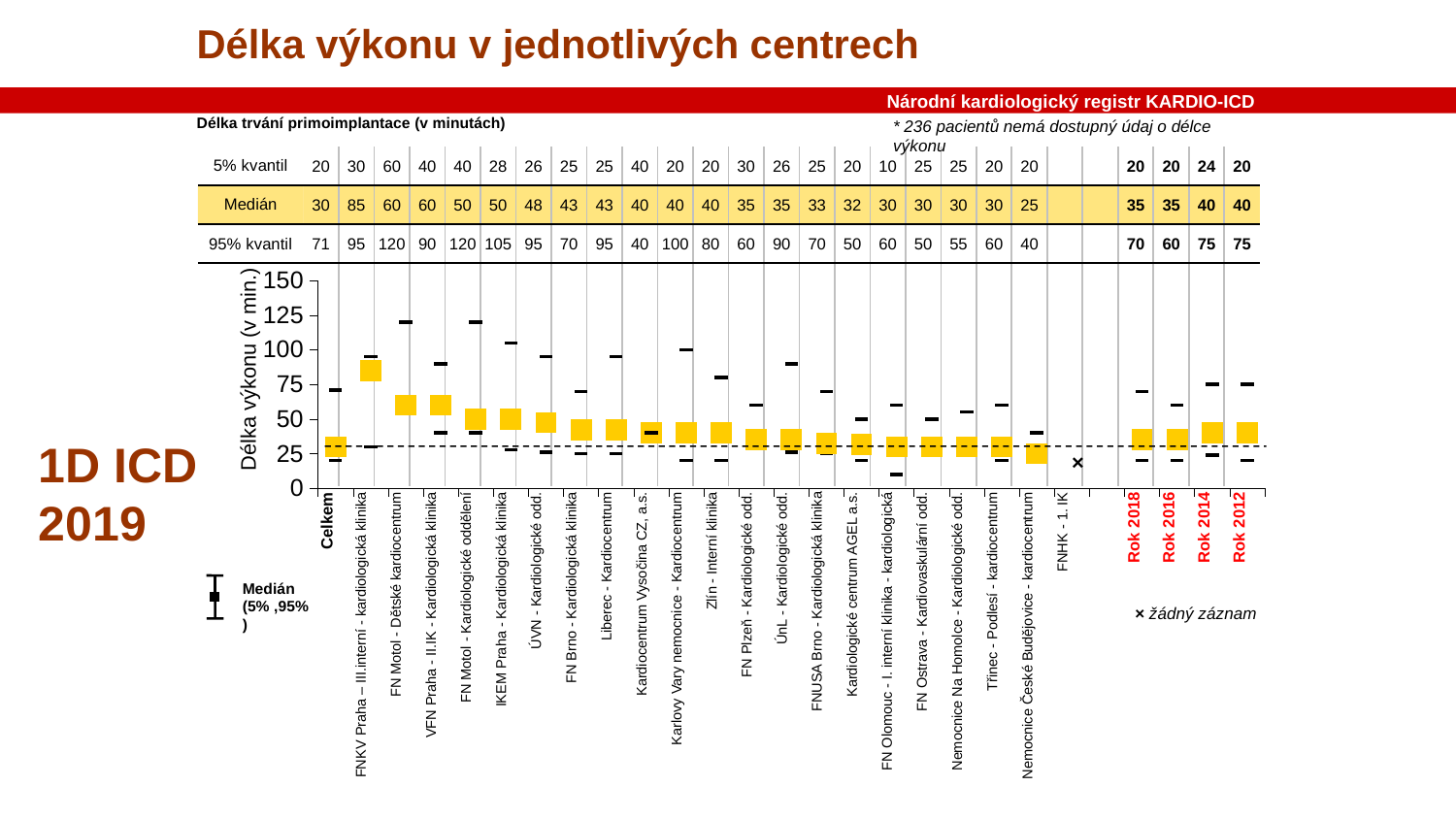
Which centre has the highest median procedure duration? FNKV Praha – III.interní - kardiologická klinika What is the 95% kvantil value for FN Motol - Dětské kardiocentrum? 120 What is the median (Medián) value for Celkem? 30 What is the label of the vertical axis of the chart? Délka výkonu (v min.) Which centre has the lowest median procedure duration? Nemocnice České Budějovice - kardiocentrum What is the 5% kvantil value for FN Olomouc - I. interní klinika - kardiologická? 10 What is the median procedure duration (Medián) for FNKV Praha – III.interní - kardiologická klinika? 85 Which has a higher median procedure duration, IKEM Praha - Kardiologická klinika or FN Plzeň - Kardiologické odd.? IKEM Praha - Kardiologická klinika Which centre is marked with an × indicating no record (žádný záznam)? FNHK - 1. IK Is the median value for Celkem greater or less than 50? less What is the median (Medián) value for Rok 2012? 40 What is the difference between the median for FNKV Praha – III.interní - kardiologická klinika and the median for Celkem? 55